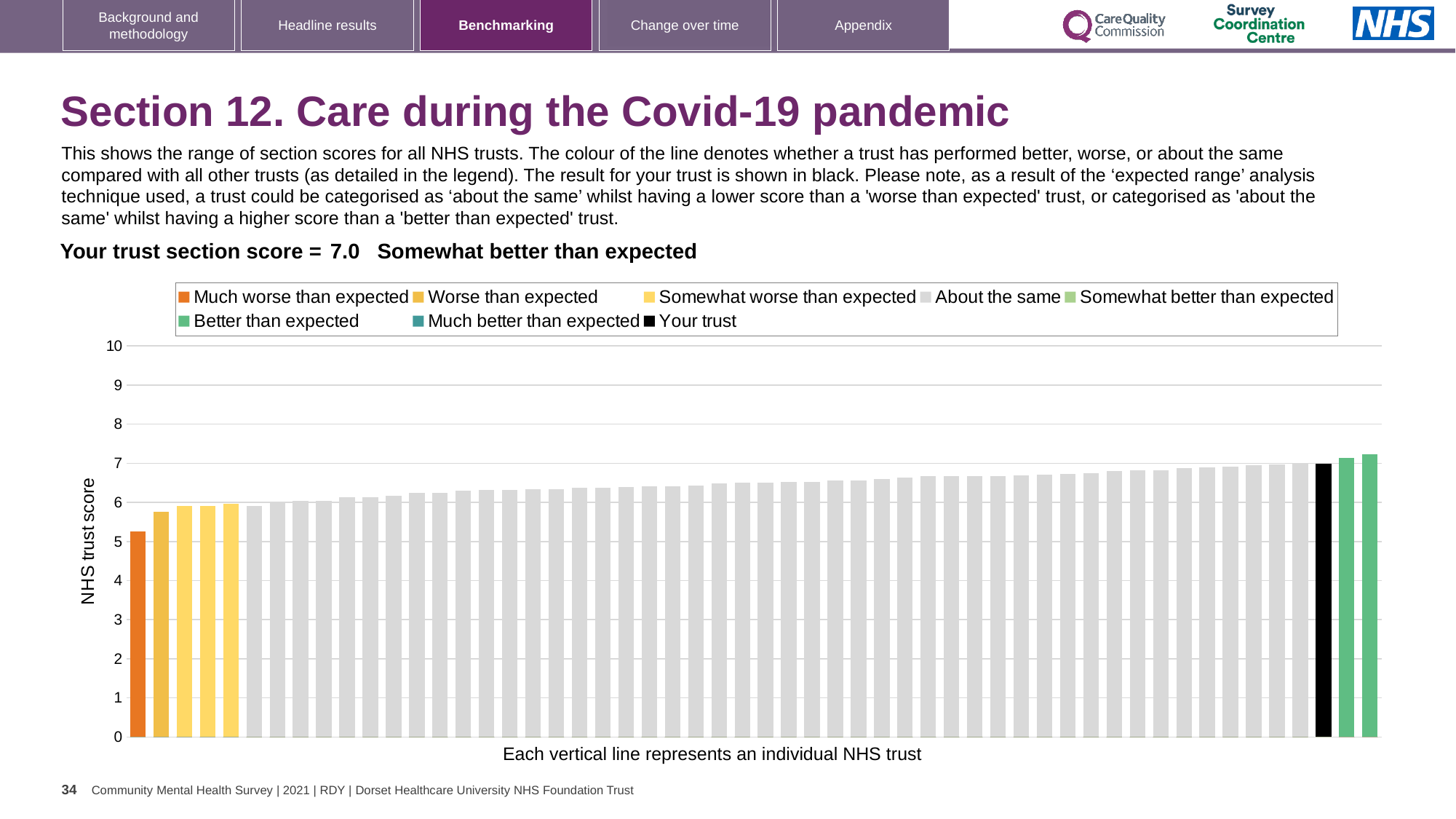
Which performance category is your trust placed in for this section? Somewhat better than expected What kind of chart is shown on the slide? bar chart How many entries does the chart legend list? 8 How many bars are coloured orange (Much worse than expected)? 1 Do the bar values rise or fall from left to right along the x axis? rise Which is larger: the bar for your trust or the orange 'Much worse than expected' bar? Your trust Is the value of the lowest bar (the orange bar) greater or less than 6? less Which legend category do the highest bars on the chart belong to? Better than expected What is the label on the vertical axis of the chart? NHS trust score What is the section score for your trust shown on the slide? 7.0 Which legend category does the lowest bar on the chart belong to? Much worse than expected Is the value of the black bar for your trust greater or less than 5? greater